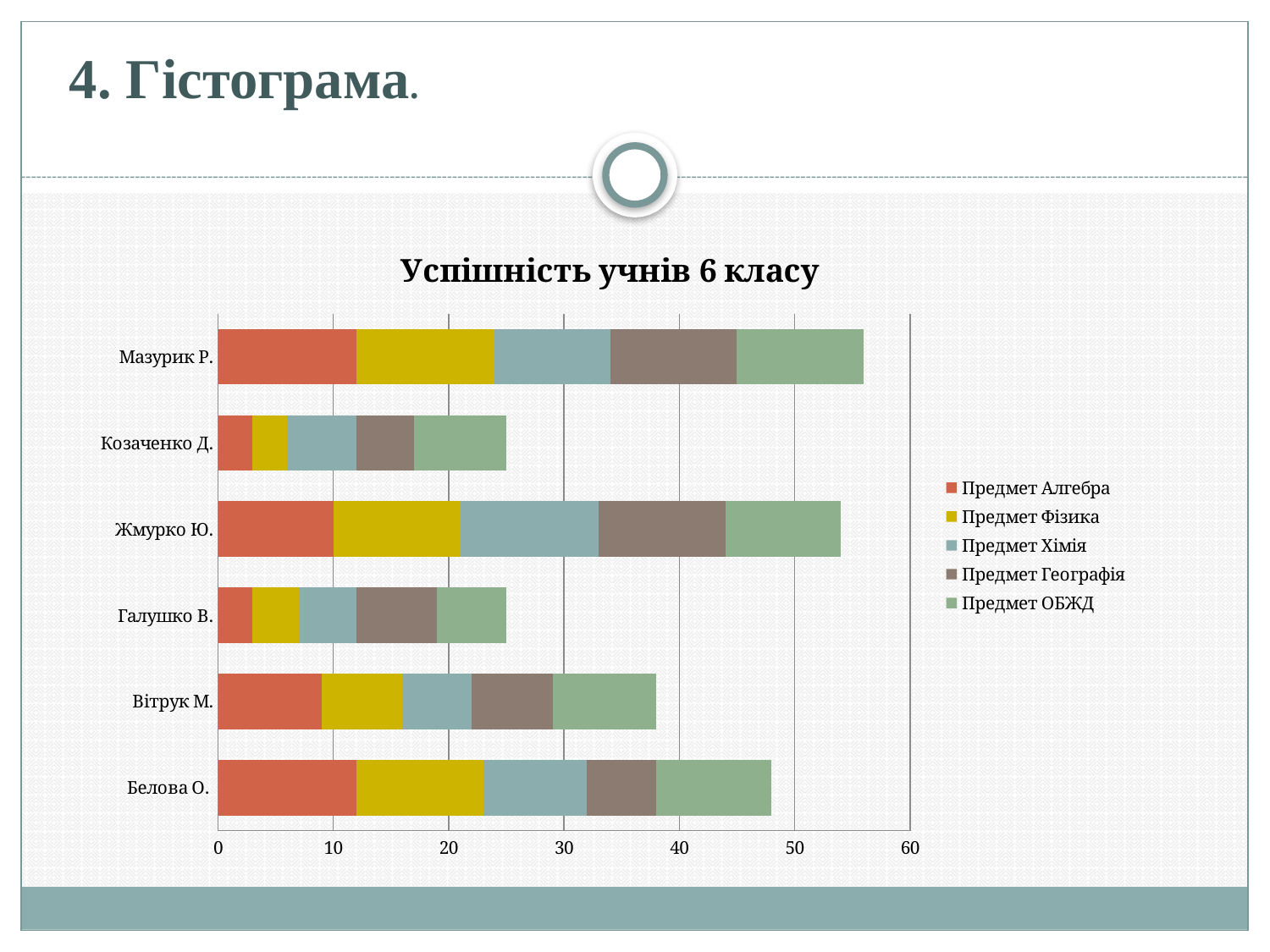
What kind of chart is shown on the slide? stacked bar chart Which has the longer total bar, Мазурик Р. or Вітрук М.? Мазурик Р. Is the total bar length for Жмурко Ю. greater or less than 50? greater Is the total bar length for Мазурик Р. greater or less than 50? greater What is the title of the chart? Успішність учнів 6 класу How many series does the legend list? 5 Is the total bar length for Вітрук М. greater or less than 40? less Which series is shown in red on the chart? Предмет Алгебра Which has the longer total bar, Белова О. or Галушко В.? Белова О. How many students (categories) are shown on the chart? 6